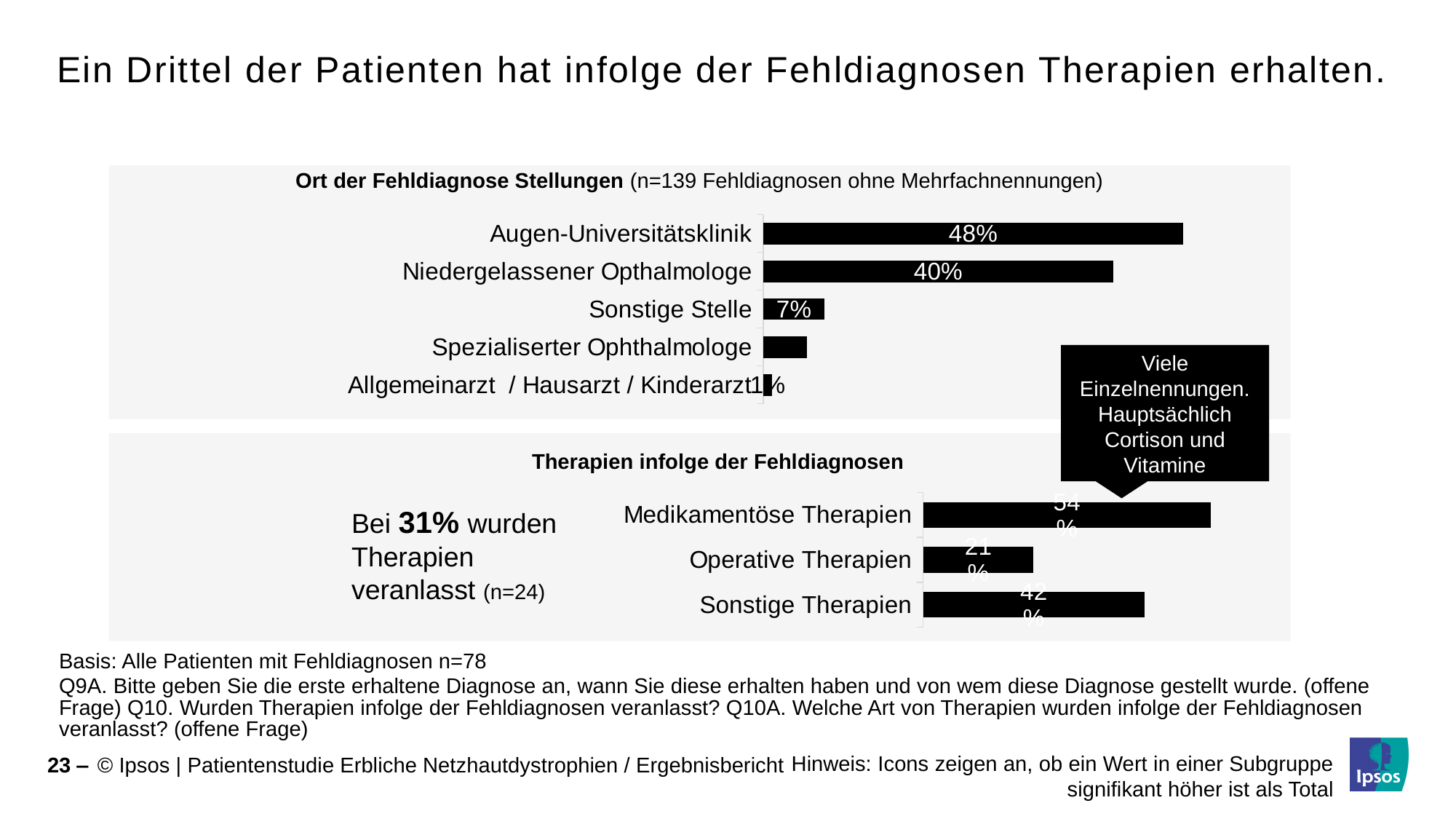
In the 'Therapien infolge der Fehldiagnosen' chart, what is the value for Operative Therapien? 21% How many categories are shown in the 'Ort der Fehldiagnose Stellungen' chart? 5 In the 'Ort der Fehldiagnose Stellungen' chart, which category has the highest value? Augen-Universitätsklinik In the 'Ort der Fehldiagnose Stellungen' chart, which category has the lowest value? Allgemeinarzt / Hausarzt / Kinderarzt In the 'Therapien infolge der Fehldiagnosen' chart, which category has the lowest value? Operative Therapien In the 'Ort der Fehldiagnose Stellungen' chart, what is the difference between Augen-Universitätsklinik and Niedergelassener Opthalmologe? 8 percentage points What type of chart is the 'Therapien infolge der Fehldiagnosen' chart? Bar chart In the 'Ort der Fehldiagnose Stellungen' chart, what is the value for Niedergelassener Opthalmologe? 40% In the 'Ort der Fehldiagnose Stellungen' chart, what is the value for Augen-Universitätsklinik? 48% In the 'Therapien infolge der Fehldiagnosen' chart, what is the value for Medikamentöse Therapien? 54% In the 'Ort der Fehldiagnose Stellungen' chart, what is the value for Sonstige Stelle? 7% In the 'Therapien infolge der Fehldiagnosen' chart, which is larger: Sonstige Therapien or Operative Therapien? Sonstige Therapien